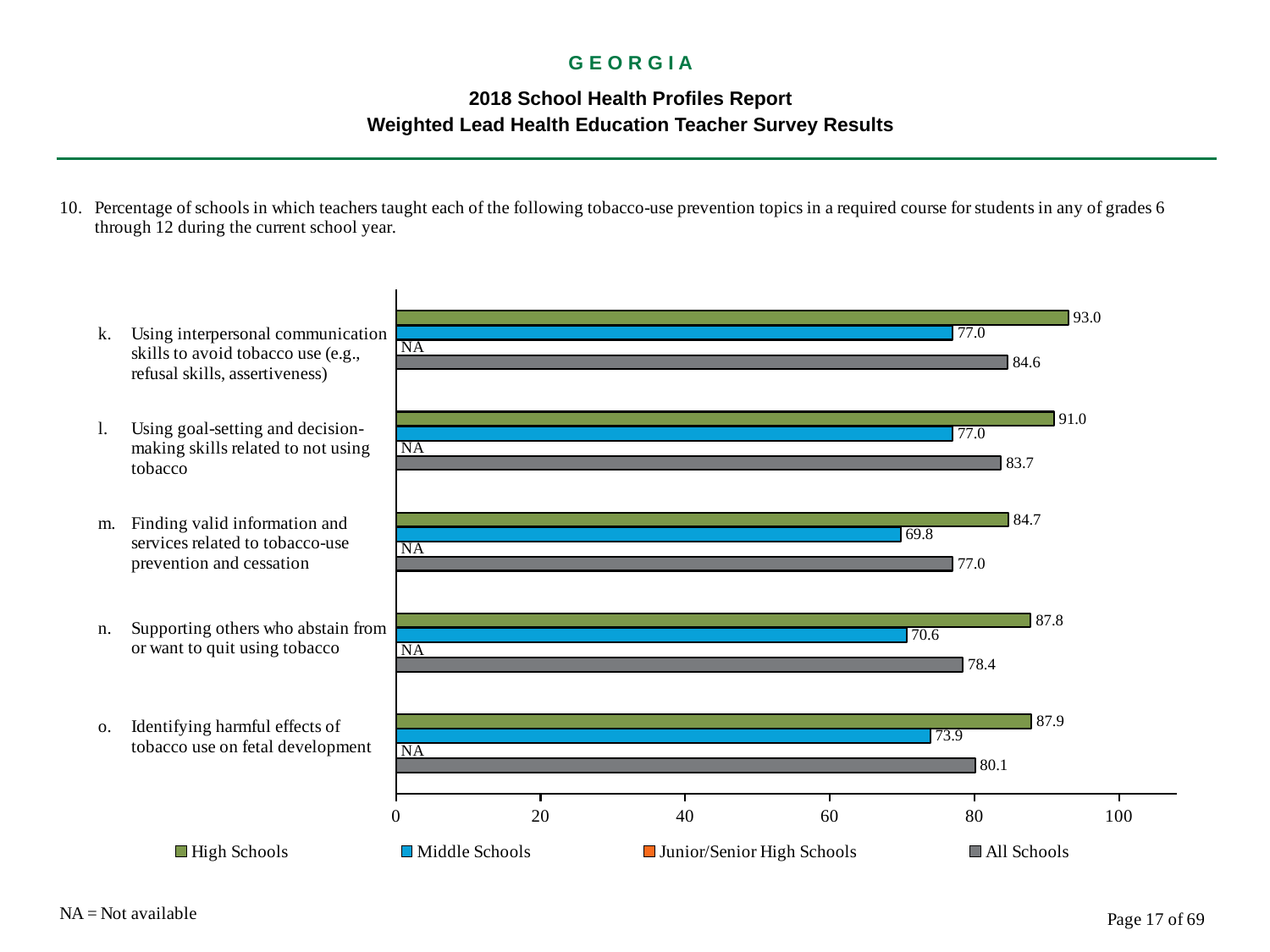
What is the All Schools value for topic o, identifying harmful effects of tobacco use on fetal development? 80.1 Which topic has the highest High Schools value? k. Using interpersonal communication skills to avoid tobacco use What does NA stand for on this slide? Not available Which topic has the lowest Middle Schools value? m. Finding valid information and services related to tobacco-use prevention and cessation What is the difference between the High Schools and Middle Schools values for topic l, using goal-setting and decision-making skills related to not using tobacco? 14.0 How many tobacco-use prevention topics are shown on the chart? 5 How many series does the legend list? 4 Which is larger for topic n: the All Schools value or the Middle Schools value? All Schools What is shown for Junior/Senior High Schools for topic n, supporting others who abstain from or want to quit using tobacco? NA What is the Middle Schools value for topic m, finding valid information and services related to tobacco-use prevention and cessation? 69.8 What kind of chart is shown on the slide? Bar chart What is the High Schools value for topic k, using interpersonal communication skills to avoid tobacco use? 93.0